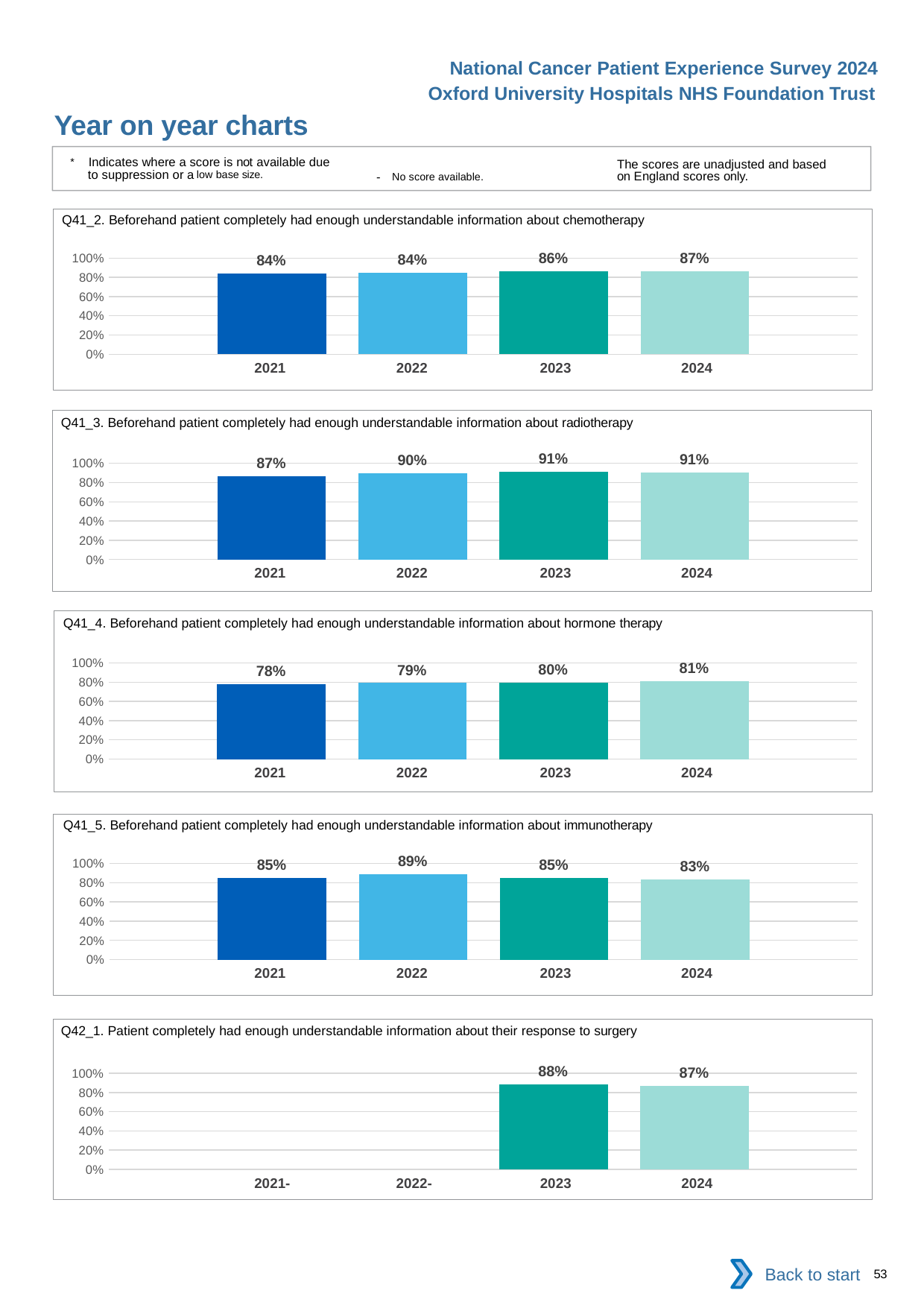
In the Q41_2 chart (chemotherapy), what is the difference between the 2021 and 2024 values? 3% In the Q42_1 chart (response to surgery), which is larger, the value for 2023 or 2024? 2023 In the Q41_3 chart (radiotherapy), do the values rise or fall from 2021 to 2023? rise How many charts are shown on the slide? 5 In the Q41_2 chart (chemotherapy), what is the value for 2024? 87% In the Q41_5 chart (immunotherapy), which year has the lowest value? 2024 What kind of chart is the Q41_2 chart (chemotherapy)? bar chart In the Q41_4 chart (hormone therapy), is the value for 2021 greater or less than 80%? less In the Q41_4 chart (hormone therapy), which year has the highest value? 2024 How many bars are plotted in the Q42_1 chart (response to surgery)? 2 In the Q41_5 chart (immunotherapy), what is the difference between the 2022 and 2024 values? 6% In the Q41_3 chart (radiotherapy), what is the value for 2021? 87%